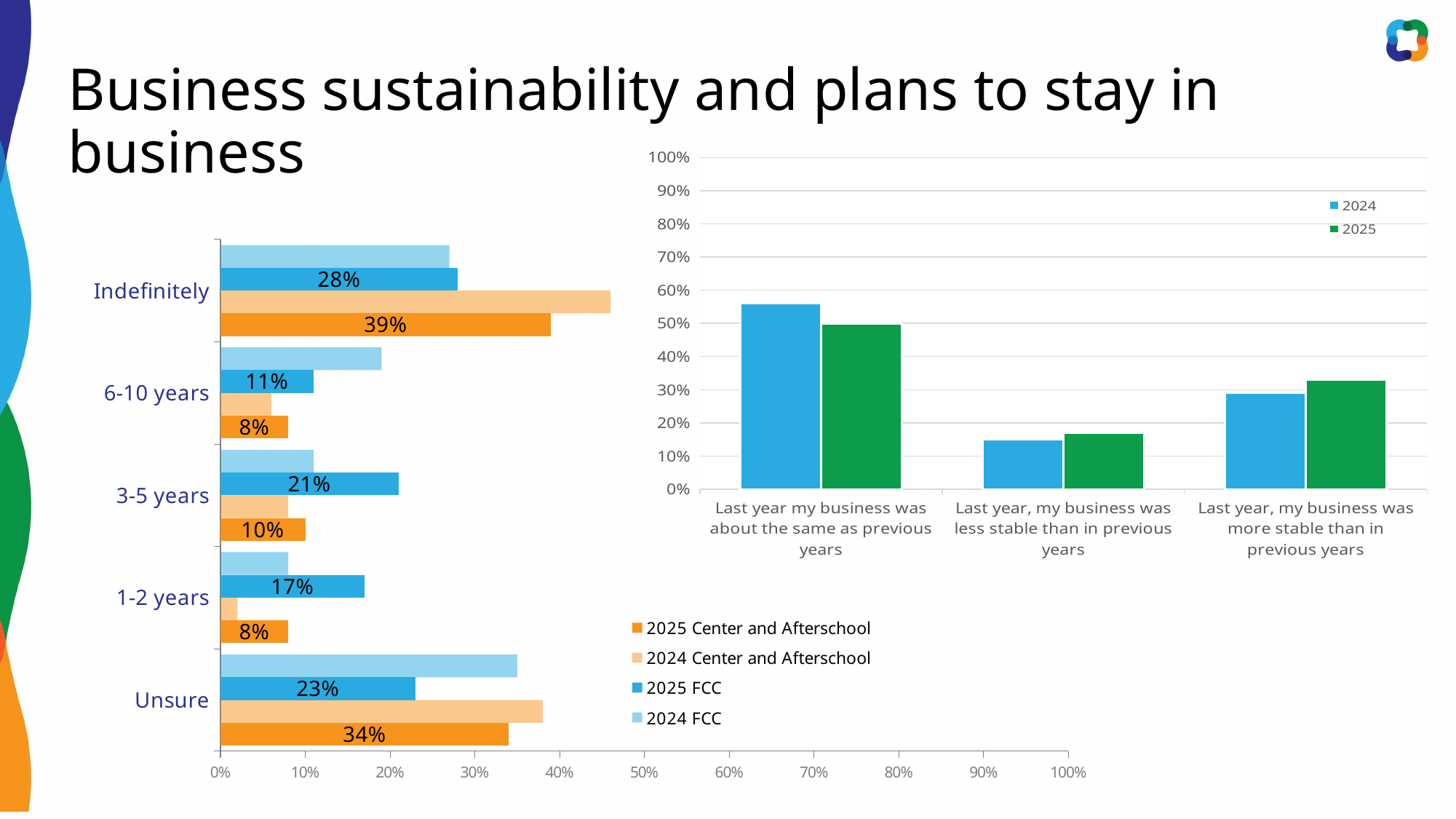
What kind of chart is the chart on the right of the slide? Bar chart In the chart on the right, is the 2024 value for 'Last year my business was about the same as previous years' greater or less than 50%? greater In the horizontal bar chart on the left, which category has the highest value for 2025 Center and Afterschool? Indefinitely In the horizontal bar chart on the left, which category has the lowest value for 2025 FCC? 6-10 years How many series does the legend of the horizontal bar chart on the left list? 4 In the horizontal bar chart on the left, what is the value for 2025 Center and Afterschool in the Indefinitely category? 39% In the horizontal bar chart on the left, what is the value for 2025 FCC in the Unsure category? 23% In the horizontal bar chart on the left, for 3-5 years, which is larger: 2025 FCC or 2025 Center and Afterschool? 2025 FCC In the chart on the right, is the 2025 value for 'Last year, my business was less stable than in previous years' greater or less than 20%? less In the horizontal bar chart on the left, what is the difference between the 2025 Center and Afterschool value and the 2025 FCC value for Indefinitely? 11 percentage points In the chart on the right, for 'Last year, my business was more stable than in previous years', which series is larger: 2024 or 2025? 2025 How many categories are shown on the horizontal bar chart on the left? 5